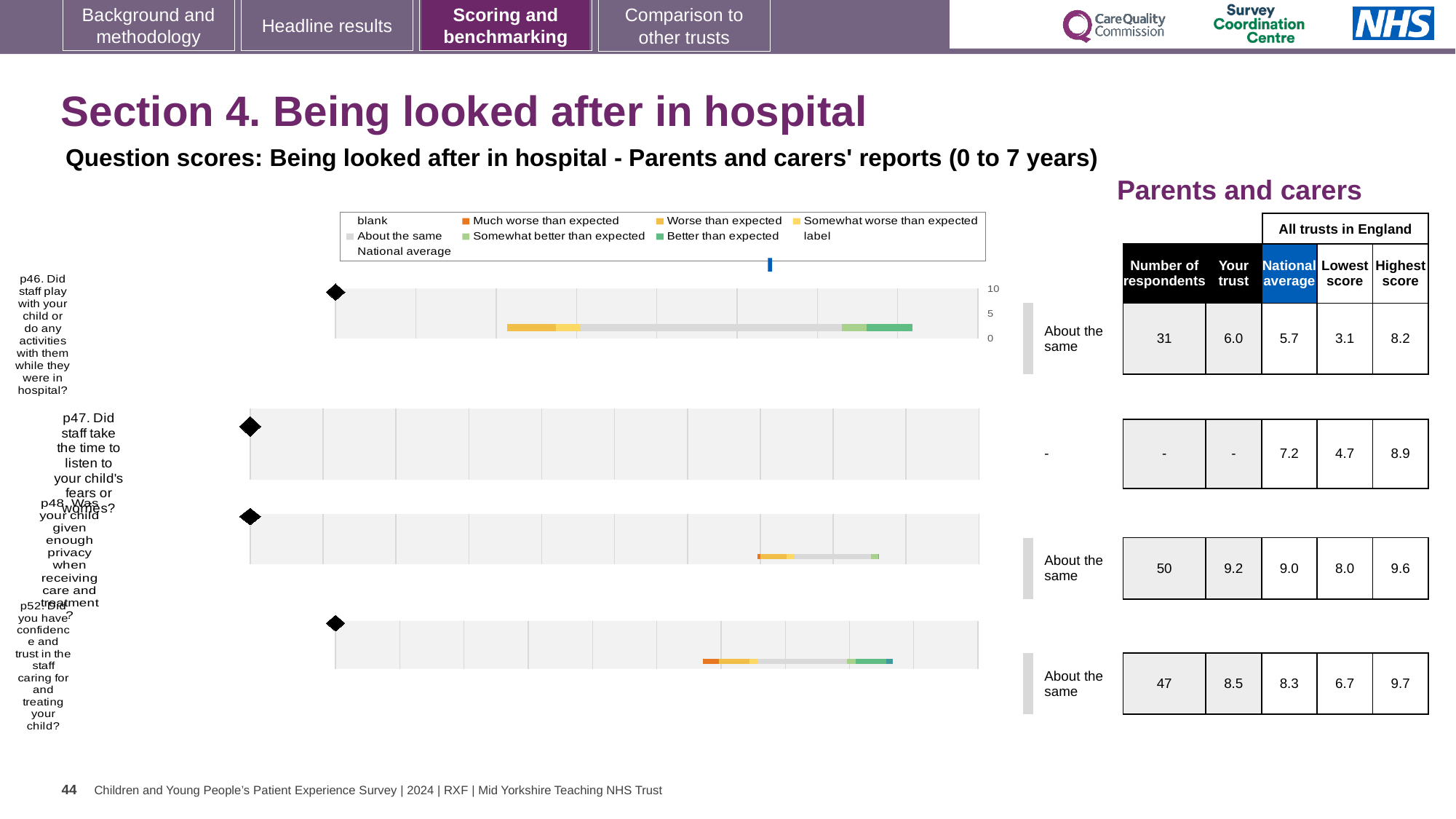
What is the lowest score across all trusts in England for question p52 (Did you have confidence and trust in the staff caring for and treating your child?)? 6.7 What is the national average score for question p48 (Was your child given enough privacy when receiving care and treatment?)? 9.0 What is the difference between the 'Your trust' score and the national average for question p52? 0.2 How many questions are plotted on this slide? 4 What benchmark category is shown for question p52? About the same What kind of chart is used to show the question scores on this slide? Bar chart What is the highest score across all trusts in England for question p47 (Did staff take the time to listen to your child's fears or worries?)? 8.9 For question p48, which is larger: the 'Your trust' score or the national average? Your trust Which question has the lowest 'Your trust' score on this slide? p46 Which question has the highest 'Your trust' score on this slide? p48 How many respondents are listed for question p46 (Did staff play with your child or do any activities with them while they were in hospital?)? 31 What is the 'Your trust' score for question p46? 6.0